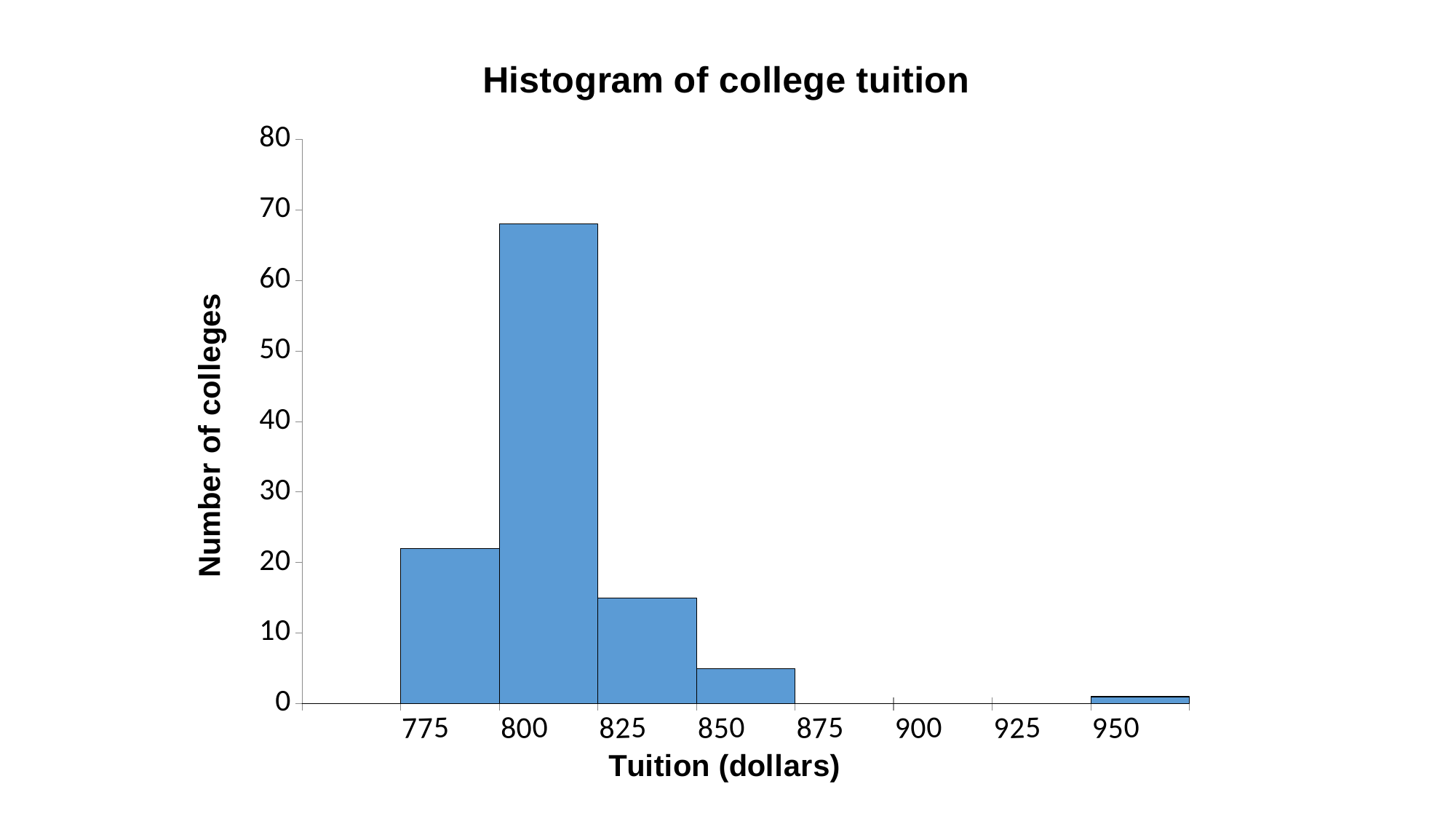
How many bars are plotted in the histogram? 5 What is the label on the vertical axis? Number of colleges What is the title of the chart? Histogram of college tuition Is the number of colleges in the 850 tuition bin greater or less than 10? less Which tuition bin has the highest number of colleges? 800 What kind of chart is shown on the slide? bar chart (histogram) Is the number of colleges in the 800 tuition bin greater or less than 60? greater Which has more colleges, the 775 tuition bin or the 825 tuition bin? 775 Is the number of colleges in the 775 tuition bin greater or less than 30? less Which has more colleges, the 850 tuition bin or the 950 tuition bin? 850